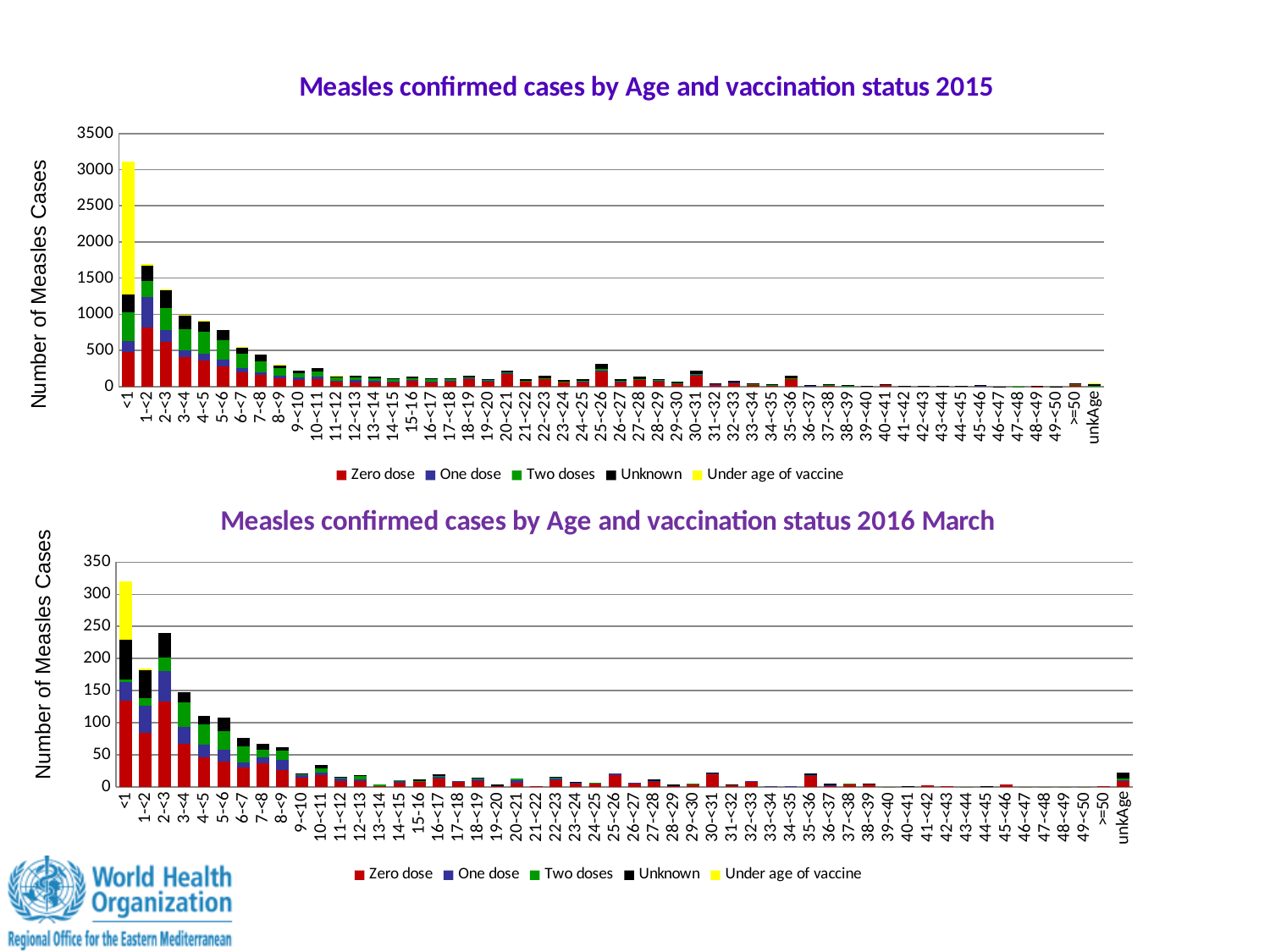
In the bottom chart (2016 March), is the total number of cases for the 1-<2 age group greater or less than 200? less In the top chart (2015), is the total number of cases for the <1 age group greater or less than 2500? greater In the bottom chart (2016 March), is the total number of cases for the 2-<3 age group greater or less than 200? greater In the top chart (2015), which legend entry is shown in yellow? Under age of vaccine In the top chart (2015), which age group has a larger total of cases: 1-<2 or 2-<3? 1-<2 In the top chart (2015), how many series does the legend list? 5 What kind of chart is the top chart, 'Measles confirmed cases by Age and vaccination status 2015'? Stacked bar chart In the bottom chart (2016 March), which age group has a larger total of cases: 1-<2 or 2-<3? 2-<3 What is the y-axis label of the bottom chart (2016 March)? Number of Measles Cases In the top chart (2015), which age category has the highest total number of measles cases? <1 In the bottom chart (2016 March), which age category has the highest total number of measles cases? <1